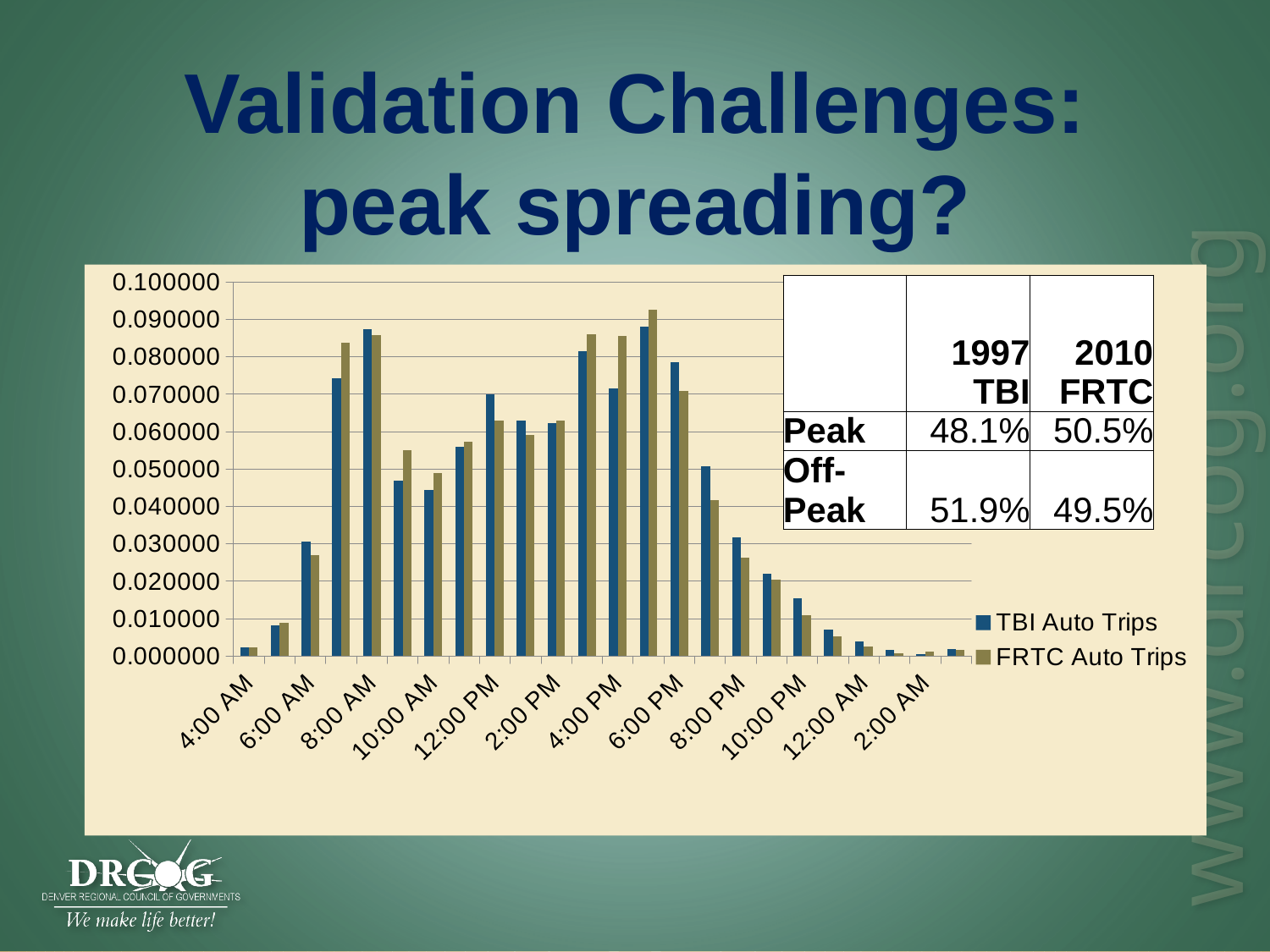
Is the FRTC Auto Trips value at 5:00 PM greater or less than 0.090000? greater Is the TBI Auto Trips value at 4:00 AM greater or less than 0.010000? less Which series is shown in blue in the chart? TBI Auto Trips What are the two series named in the chart legend? TBI Auto Trips and FRTC Auto Trips At 9:00 AM, which series has the larger value, TBI Auto Trips or FRTC Auto Trips? FRTC Auto Trips What kind of chart is shown on the slide? bar chart At 6:00 PM, which series has the larger value, TBI Auto Trips or FRTC Auto Trips? TBI Auto Trips Do the TBI Auto Trips values rise or fall from 6:00 PM to 2:00 AM? fall Is the FRTC Auto Trips value at 7:00 PM greater or less than 0.050000? less At which time does the FRTC Auto Trips series reach its highest value? 5:00 PM How many series does the chart legend list? 2